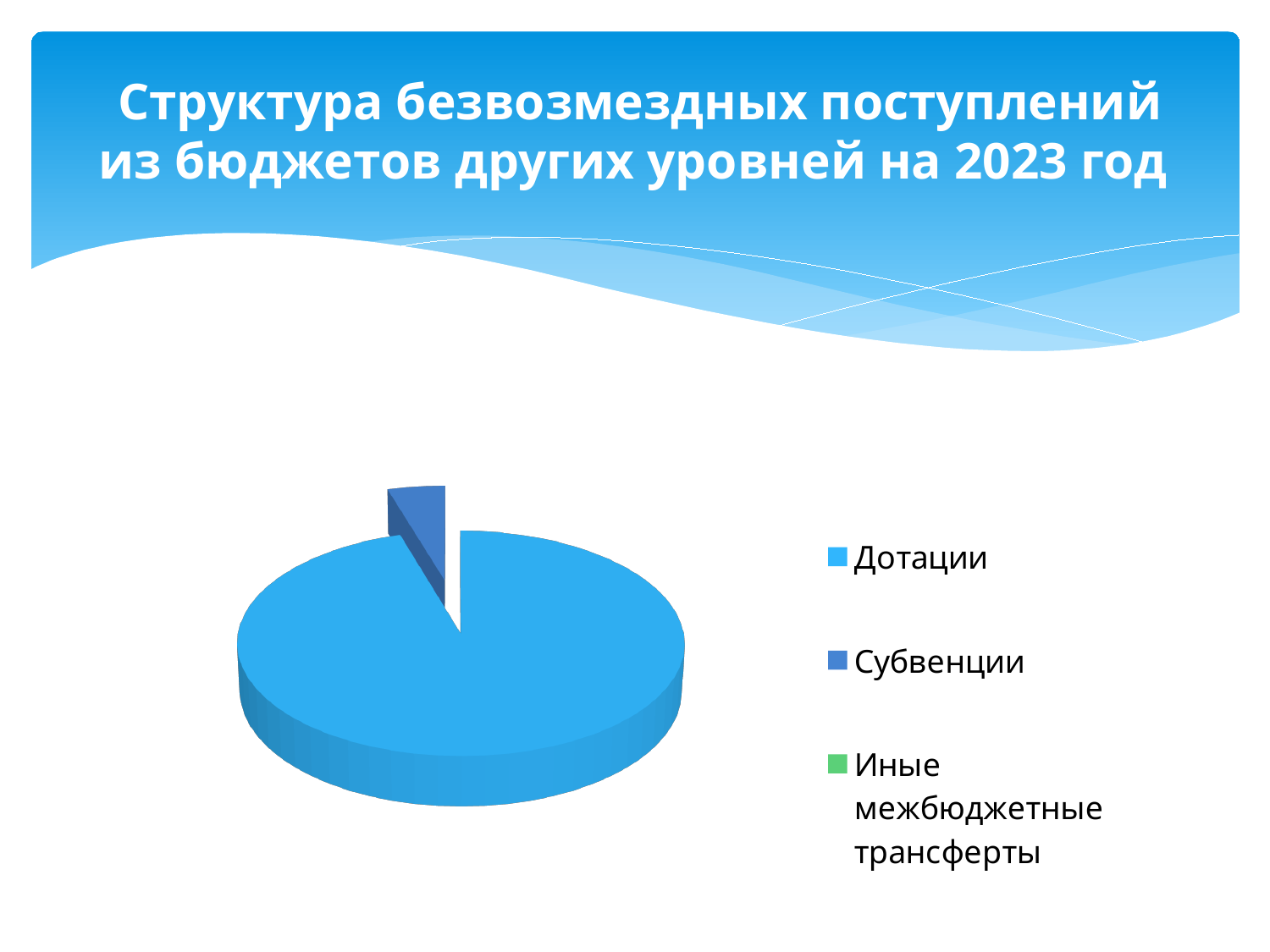
How many categories does the legend list? 3 What is the title of the slide containing the chart? Структура безвозмездных поступлений из бюджетов других уровней на 2023 год Which category has the largest slice of the pie? Дотации What colour is the slice for Дотации? light blue Which is larger, the slice for Дотации or the slice for Субвенции? Дотации Which legend entry is shown in green? Иные межбюджетные трансферты What kind of chart is shown on the slide? pie chart